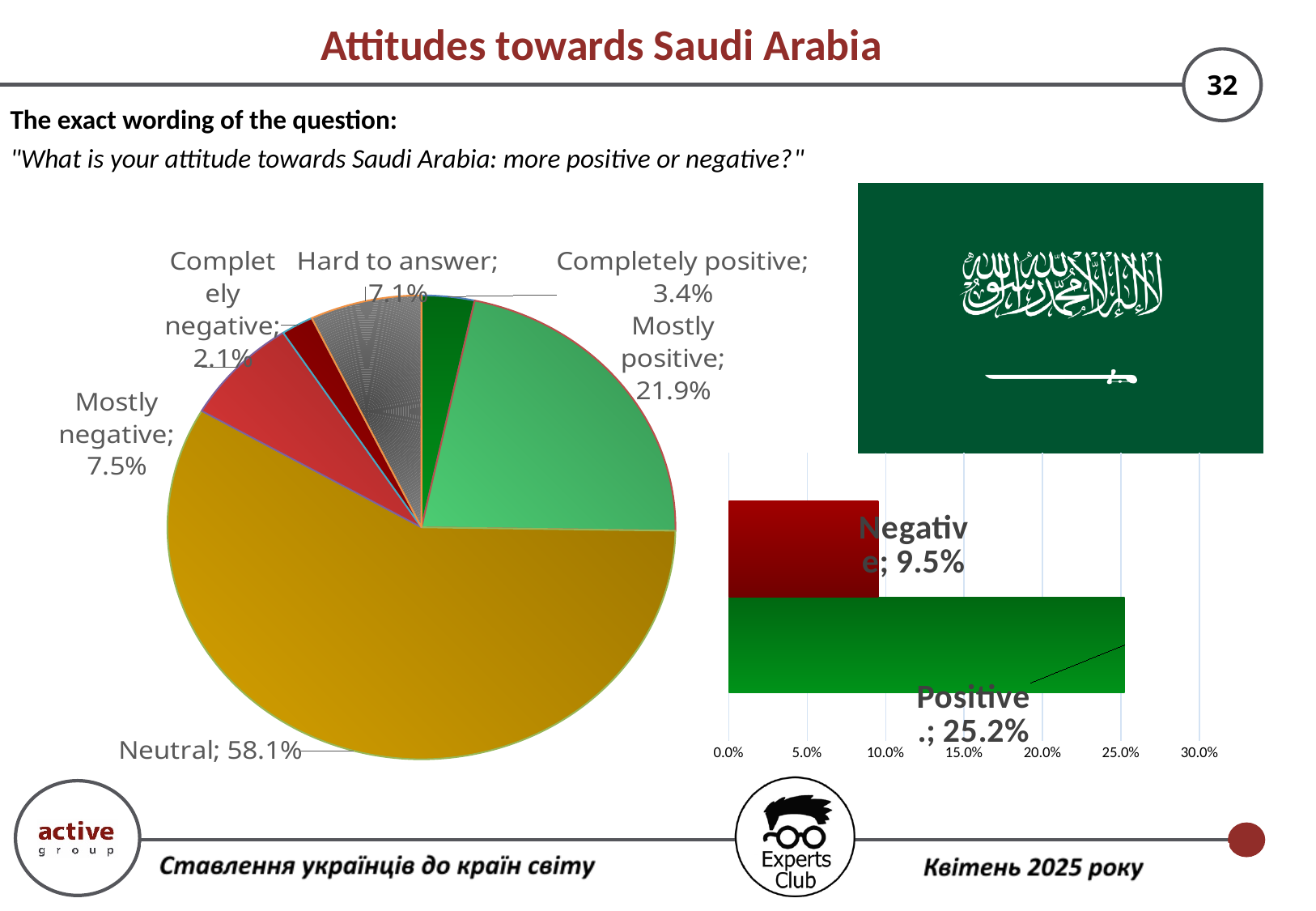
In the pie chart on the left, what is the difference between "Mostly positive" and "Mostly negative"? 14.4% In the bar chart on the right, what is the difference between "Positive" and "Negative"? 15.7% In the pie chart on the left, what share of respondents answered "Neutral"? 58.1% In the pie chart on the left, which is larger: "Completely positive" or "Mostly negative"? Mostly negative In the pie chart on the left, which category has the smallest share? Completely negative In the pie chart on the left, which category has the largest share? Neutral In the pie chart on the left, what is the value for "Mostly positive"? 21.9% How many categories does the pie chart on the left show? 6 What type of chart is shown on the right side of the slide? Bar chart In the bar chart on the right, what is the value for "Positive"? 25.2% In the pie chart on the left, what is the value for "Hard to answer"? 7.1% In the pie chart on the left, what is the value for "Completely negative"? 2.1%